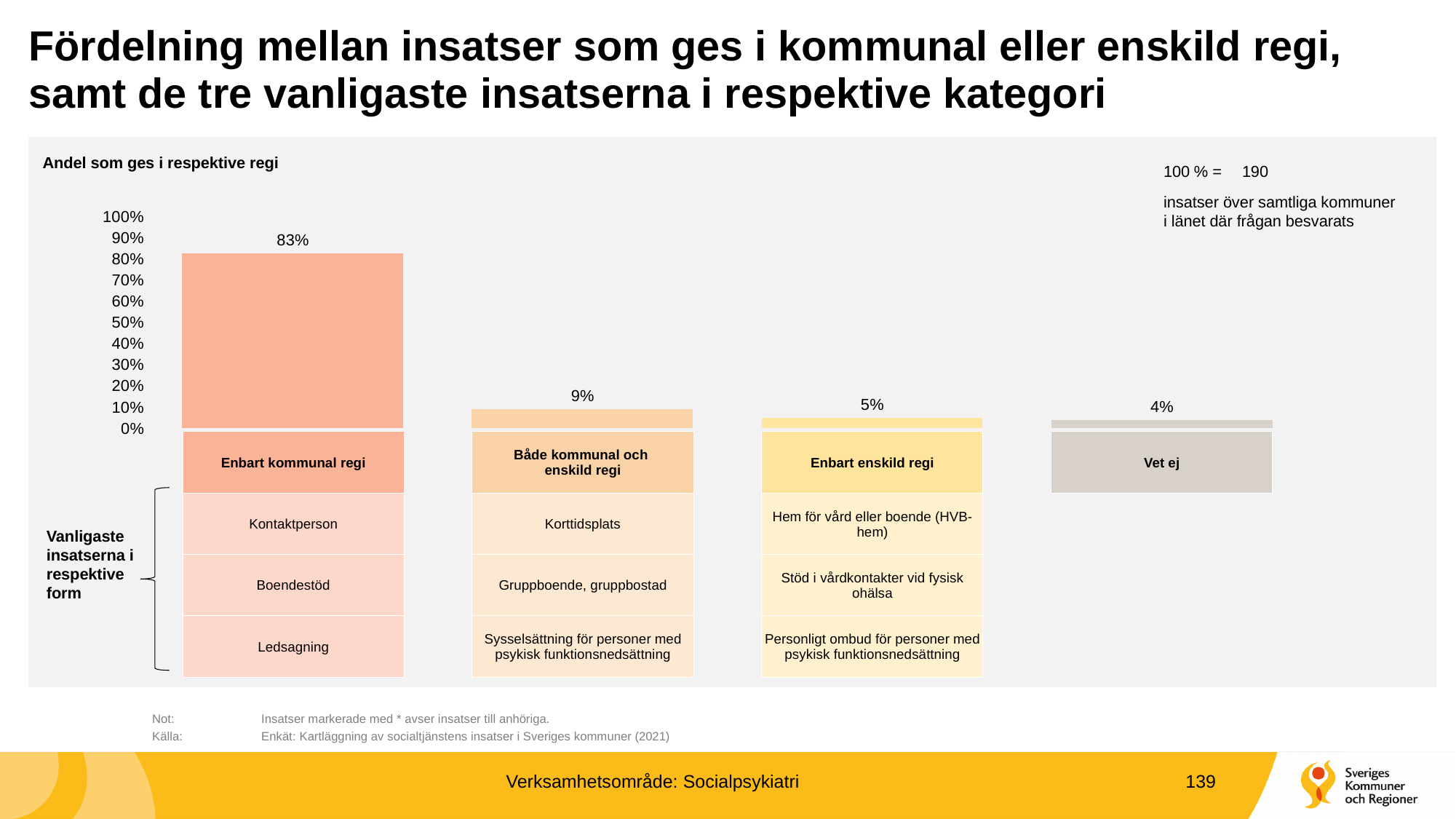
What is the value for Både kommunal och enskild regi? 9% What is the value for Enbart kommunal regi? 83% What is the value for Vet ej? 4% What kind of chart is shown on the slide? bar chart Which category has the highest value? Enbart kommunal regi Which is larger, the value for Både kommunal och enskild regi or the value for Enbart enskild regi? Både kommunal och enskild regi Is the value for Enbart kommunal regi greater or less than 50%? greater What is the value for Enbart enskild regi? 5% How many categories are shown in the bar chart? 4 What is the difference between the values for Enbart kommunal regi and Både kommunal och enskild regi? 74% Which category has the lowest value? Vet ej According to the note on the slide, how many insatser does 100% correspond to? 190